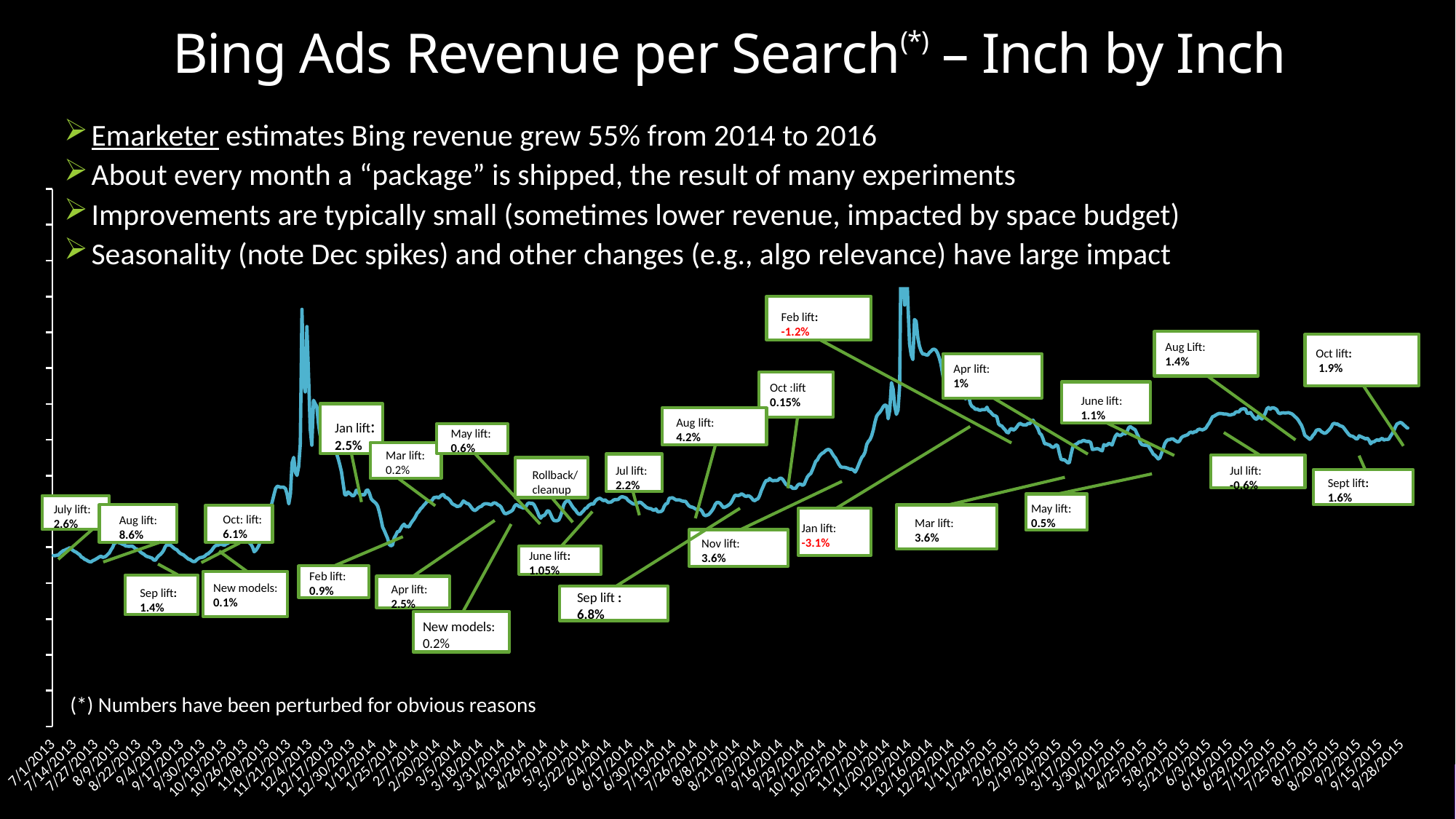
What is the Feb lift value shown in red in the callout near the top of the chart? -1.2% Which is larger, the Aug lift of 4.2% or the Jul lift of 2.2%? Aug lift 4.2% What is the title of the slide containing the chart? Bing Ads Revenue per Search(*) – Inch by Inch What is the Oct lift value shown in the rightmost callout? 1.9% How many callouts on the chart show a negative lift value? 3 What is the largest lift percentage shown in any callout on the chart? 8.6% What is the lowest lift percentage shown in any callout on the chart? -3.1% What is the Nov lift value shown in the callout? 3.6% What is the difference between the Sep lift of 6.8% and the Nov lift of 3.6%? 3.2% What is the first date label on the x axis? 7/1/2013 What kind of chart is shown on the slide? line chart What is the Jul lift value shown in the callout with a negative number? -0.6%